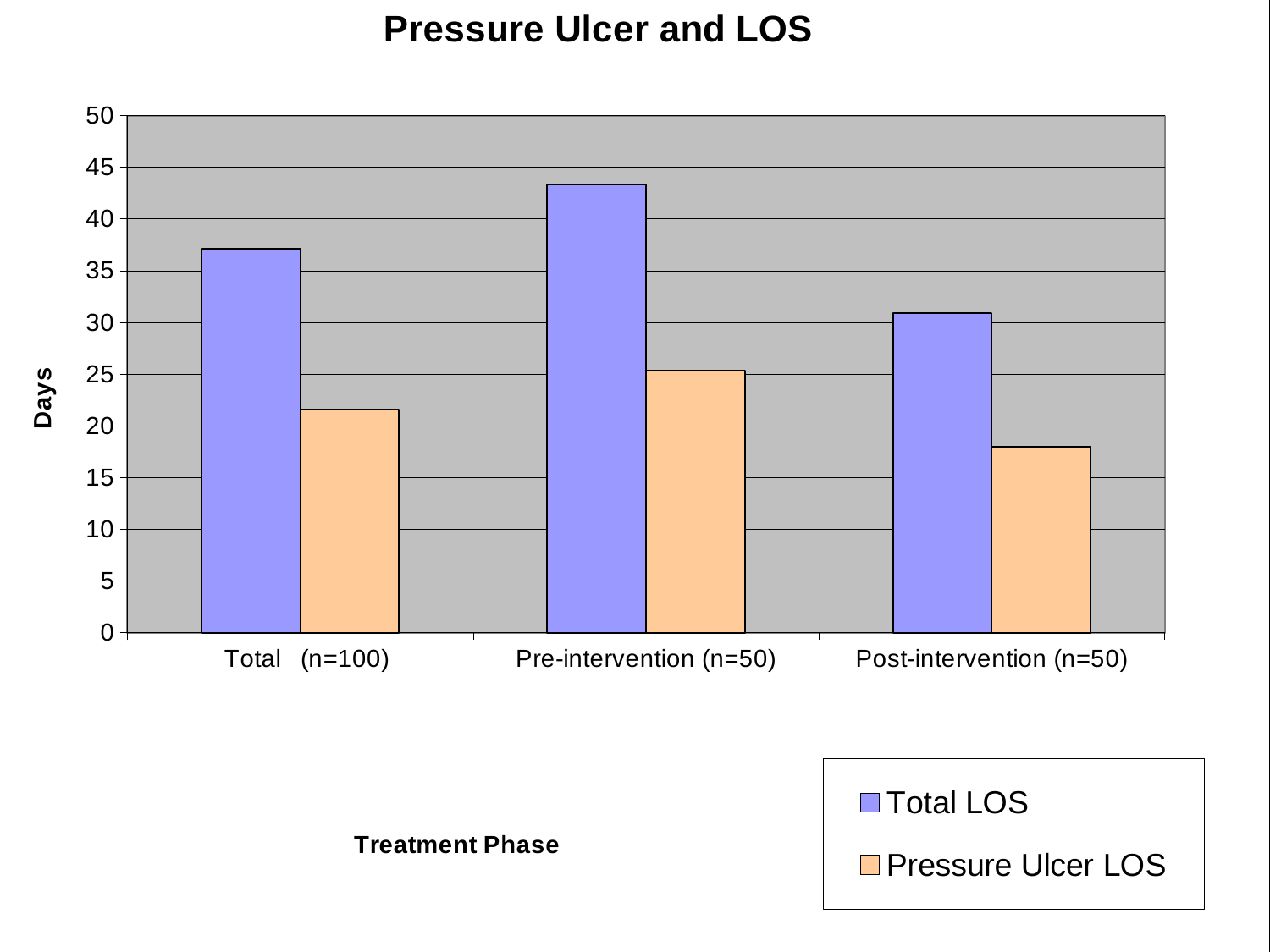
Is the Total LOS for Pre-intervention (n=50) greater or less than 40? greater Which treatment phase has the lowest Total LOS? Post-intervention (n=50) Which is larger for Pre-intervention (n=50): Total LOS or Pressure Ulcer LOS? Total LOS Is the Pressure Ulcer LOS for Post-intervention (n=50) greater or less than 20? less How many treatment phase categories are shown on the x axis? 3 What type of chart is shown on the slide? bar chart Is the Total LOS for Post-intervention (n=50) greater or less than 35? less Which treatment phase has the highest Total LOS? Pre-intervention (n=50) What is the label of the y axis? Days Which treatment phase has the lowest Pressure Ulcer LOS? Post-intervention (n=50) How many series does the legend list? 2